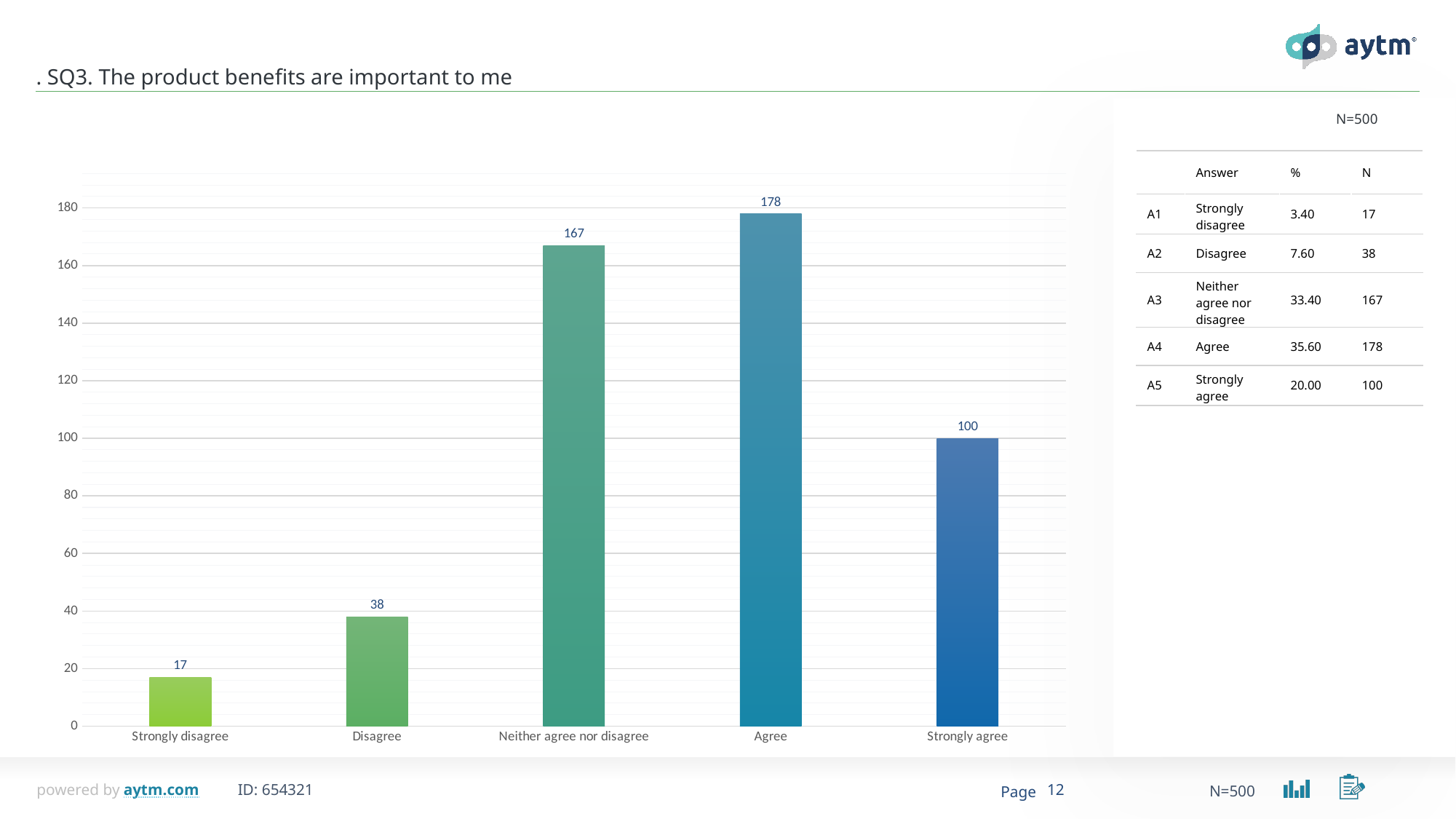
What is the difference between the values for Agree and Neither agree nor disagree? 11 What is the value for Neither agree nor disagree? 167 Is the value for Strongly agree greater or less than 120? less What is the value for Strongly disagree? 17 Which category has the highest value? Agree What is the title of the chart? SQ3. The product benefits are important to me What is the value for Agree? 178 How many categories are shown on the x axis? 5 Which category has the lowest value? Strongly disagree What kind of chart is shown on the slide? bar chart Which is larger, the value for Strongly agree or the value for Disagree? Strongly agree What is the difference between the values for Strongly agree and Disagree? 62